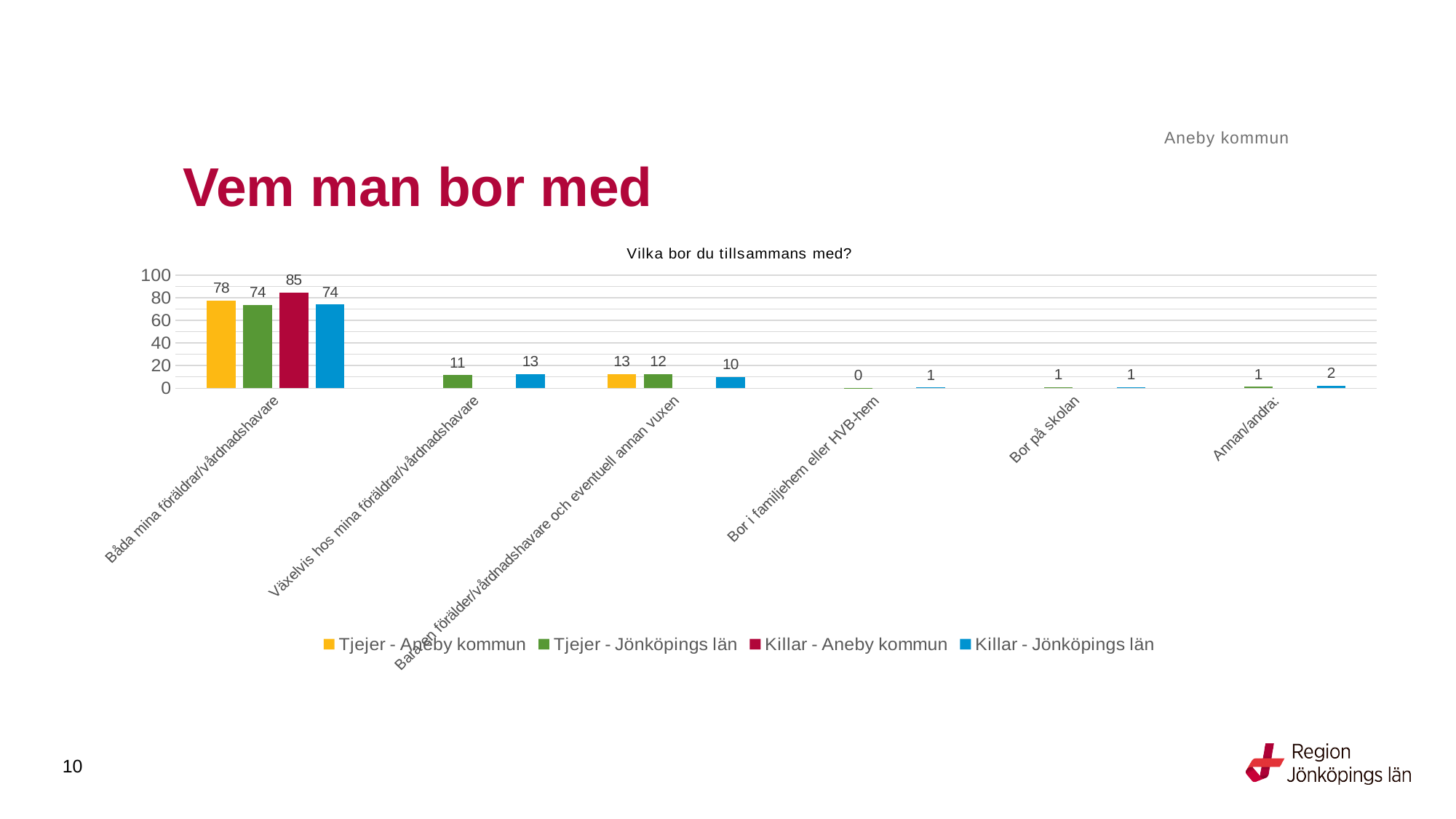
What is the title of the chart? Vilka bor du tillsammans med? What is the value for Tjejer - Aneby kommun in the category 'Båda mina föräldrar/vårdnadshavare'? 78 What is the value for Killar - Jönköpings län in the category 'Växelvis hos mina föräldrar/vårdnadshavare'? 13 What is the value for Tjejer - Aneby kommun in the category 'Bara en förälder/vårdnadshavare och eventuell annan vuxen'? 13 What is the value for Tjejer - Jönköpings län in the category 'Växelvis hos mina föräldrar/vårdnadshavare'? 11 Which series has the highest value in the category 'Båda mina föräldrar/vårdnadshavare'? Killar - Aneby kommun What is the value for Killar - Aneby kommun in the category 'Båda mina föräldrar/vårdnadshavare'? 85 What is the difference between Killar - Aneby kommun and Killar - Jönköpings län in the category 'Båda mina föräldrar/vårdnadshavare'? 11 In the category 'Båda mina föräldrar/vårdnadshavare', which is larger: Tjejer - Aneby kommun or Tjejer - Jönköpings län? Tjejer - Aneby kommun How many categories are shown on the x axis of the chart? 6 What is the value for Killar - Jönköpings län in the category 'Annan/andra'? 2 How many series does the legend list? 4